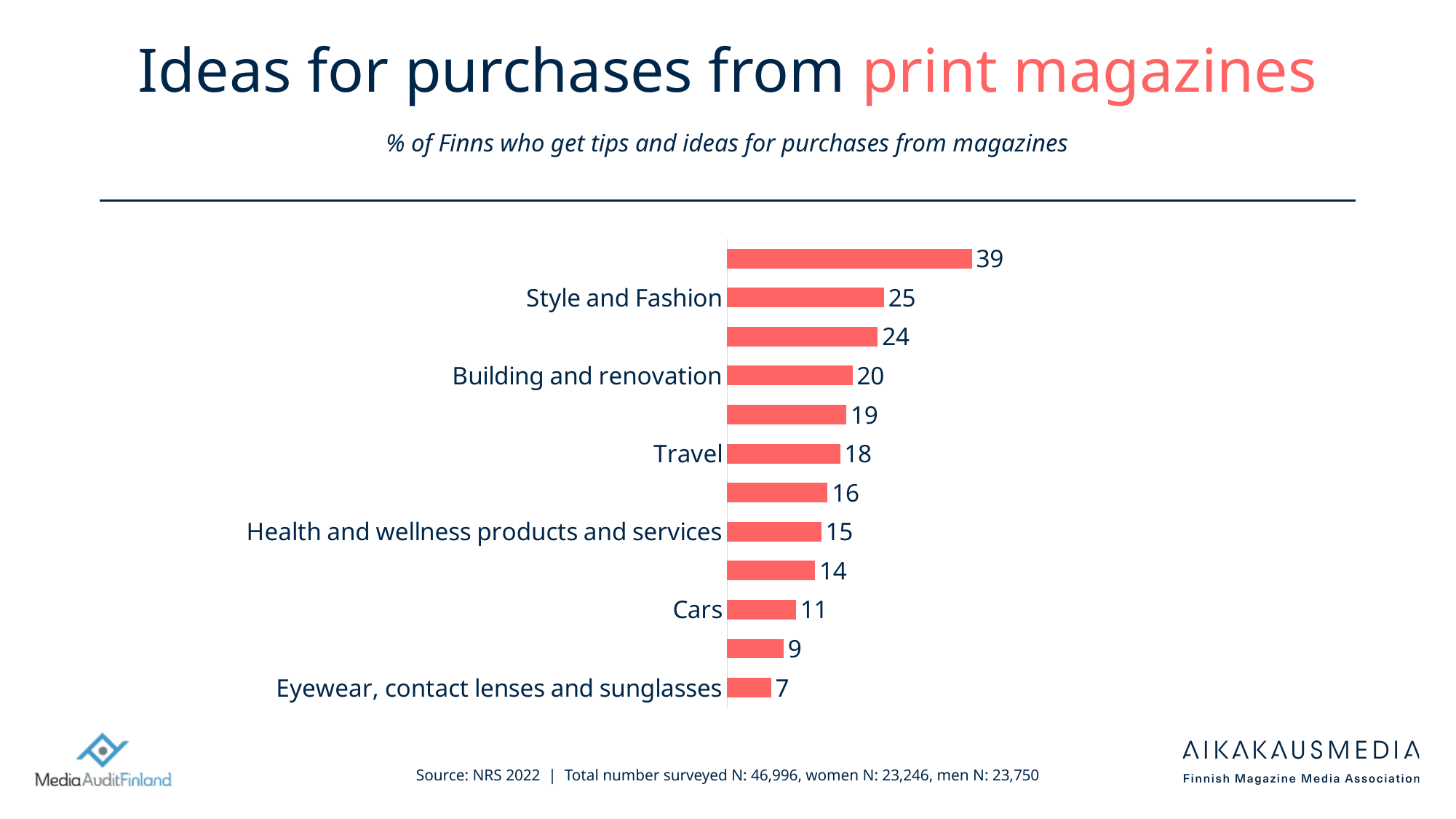
What is the value for Style and Fashion? 25 What is the value for Travel? 18 What is the difference between the values for Style and Fashion and Cars? 14 What is the highest value shown on the chart? 39 How many bars are plotted on the chart? 12 Which is larger, the value for Travel or the value for Health and wellness products and services? Travel What is the value for Cars? 11 Do the bar values increase or decrease from the top of the chart to the bottom? Decrease Which category has the lowest value? Eyewear, contact lenses and sunglasses What is the value for Health and wellness products and services? 15 What kind of chart is shown on the slide? Bar chart What is the value for Building and renovation? 20